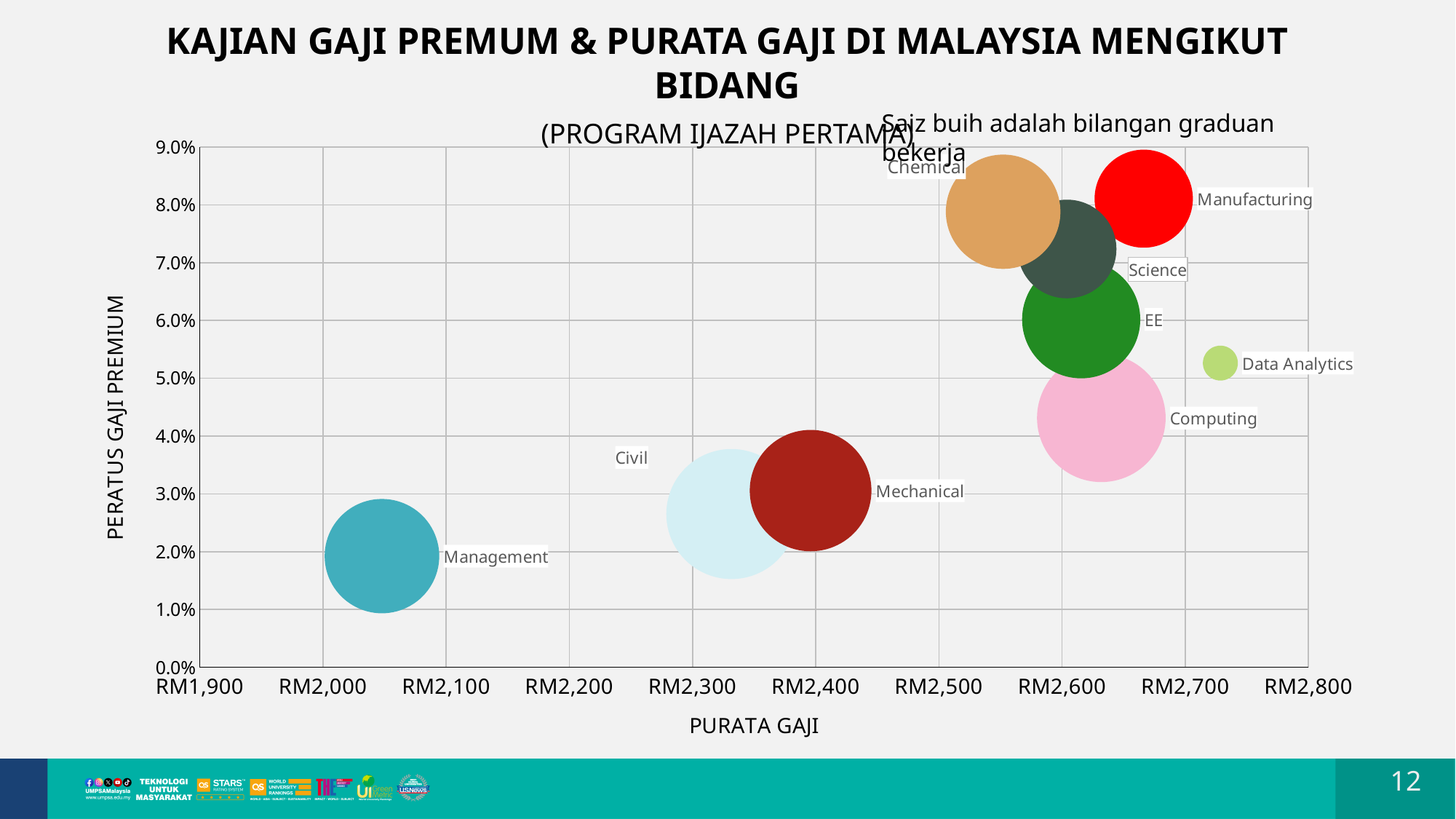
How many fields (bubbles) are plotted on the chart? 9 What kind of chart is shown on the slide? Bubble chart Is the salary premium percentage for Management greater or less than 3.0%? less Is the average salary for Data Analytics greater or less than RM2,700? greater Which field is represented by the smallest bubble? Data Analytics Is the salary premium percentage for Chemical greater or less than 7.0%? greater Which field has the highest average salary (PURATA GAJI)? Data Analytics What does the bubble size represent according to the note on the chart? Bilangan graduan bekerja Which has a higher salary premium percentage, EE or Computing? EE Which field has the lowest percentage of salary premium (PERATUS GAJI PREMIUM)? Management Which field has the lowest average salary (PURATA GAJI)? Management